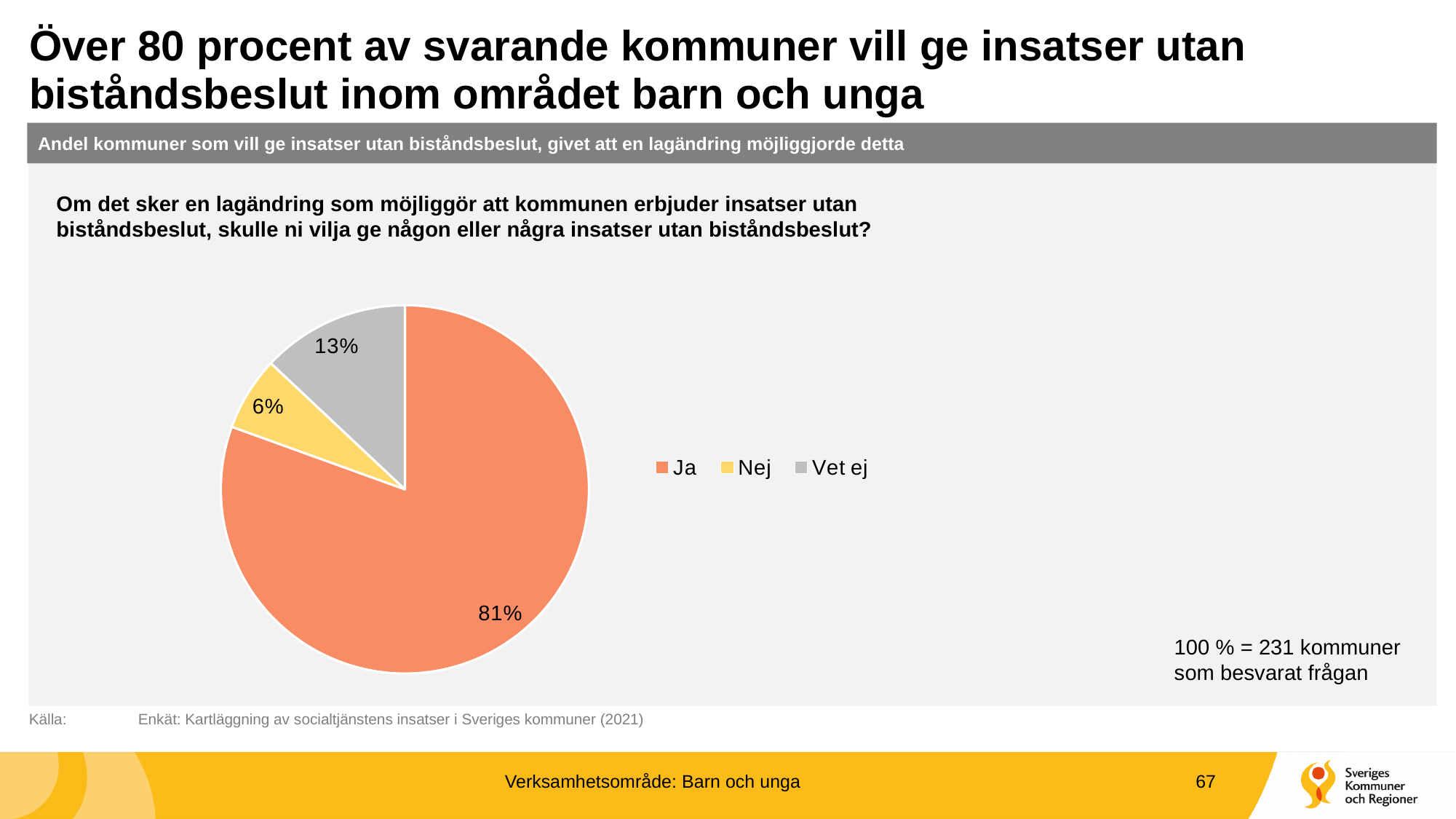
Which category has the largest slice of the pie? Ja What share of the pie does the "Ja" slice represent? 81% Which slice is larger, "Nej" or "Vet ej"? Vet ej What is the difference in percentage points between the "Vet ej" slice and the "Nej" slice? 7 What kind of chart is shown on the slide? Pie chart How many categories does the pie chart show? 3 How many municipalities answered the question, according to the note on the slide? 231 Which category has the smallest slice of the pie? Nej What is the difference in percentage points between the "Ja" slice and the "Vet ej" slice? 68 What colour is the "Ja" slice in the pie chart? Orange What share of the pie does the "Nej" slice represent? 6% What share of the pie does the "Vet ej" slice represent? 13%